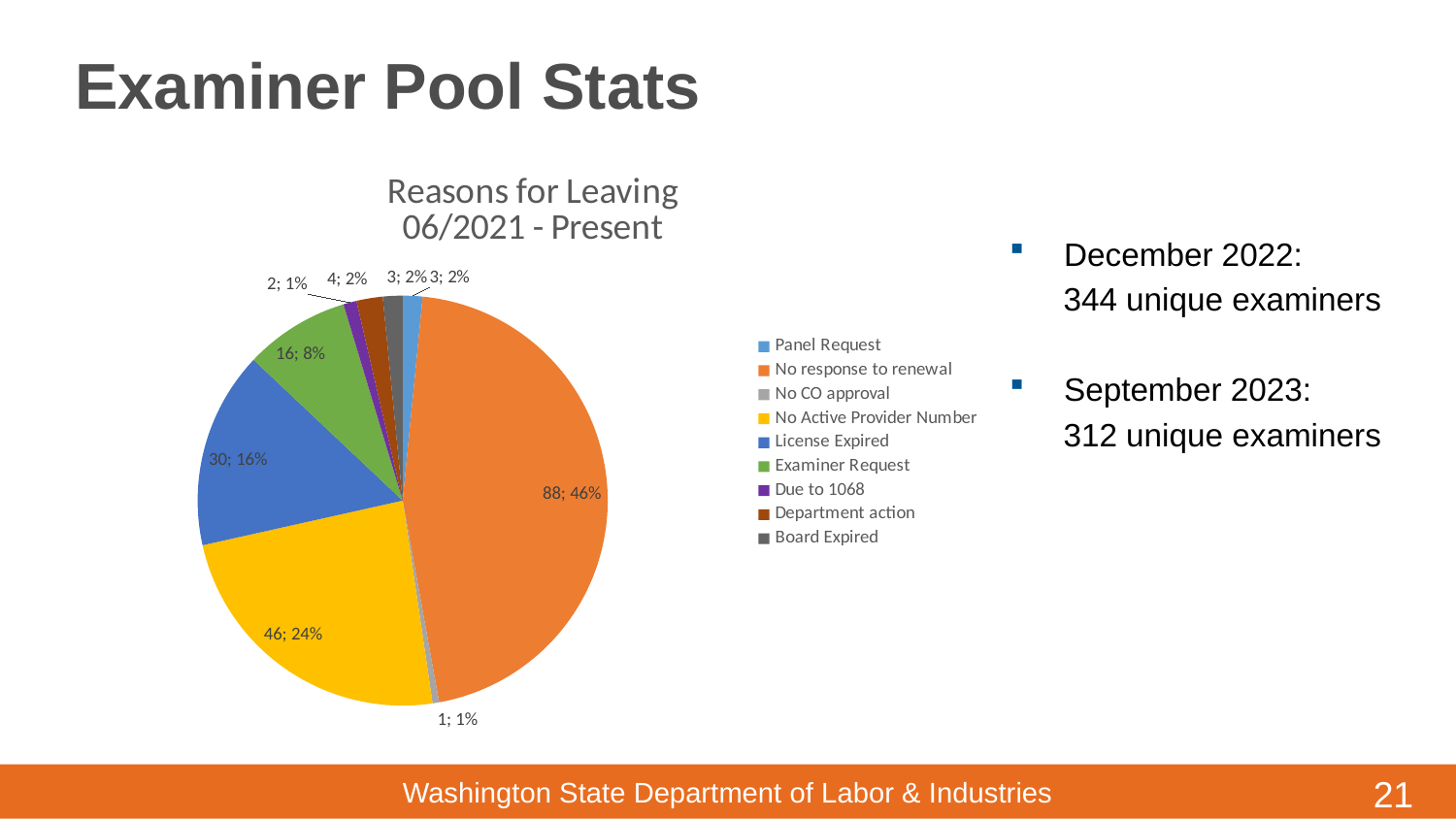
Which reason for leaving has the largest slice of the pie? No response to renewal What is the difference in count between No response to renewal and No Active Provider Number? 42 What is the value shown for License Expired? 30; 16% What is the value shown for No Active Provider Number? 46; 24% What is the value shown for Examiner Request? 16; 8% What is the title of the chart? Reasons for Leaving 06/2021 - Present Which reason for leaving has the smallest slice of the pie? No CO approval What is the value shown for No response to renewal? 88; 46% Which is larger, the slice for License Expired or the slice for Examiner Request? License Expired What type of chart is shown on the slide? pie chart What share of the pie does License Expired represent? 16% How many categories does the legend of the pie chart list? 9